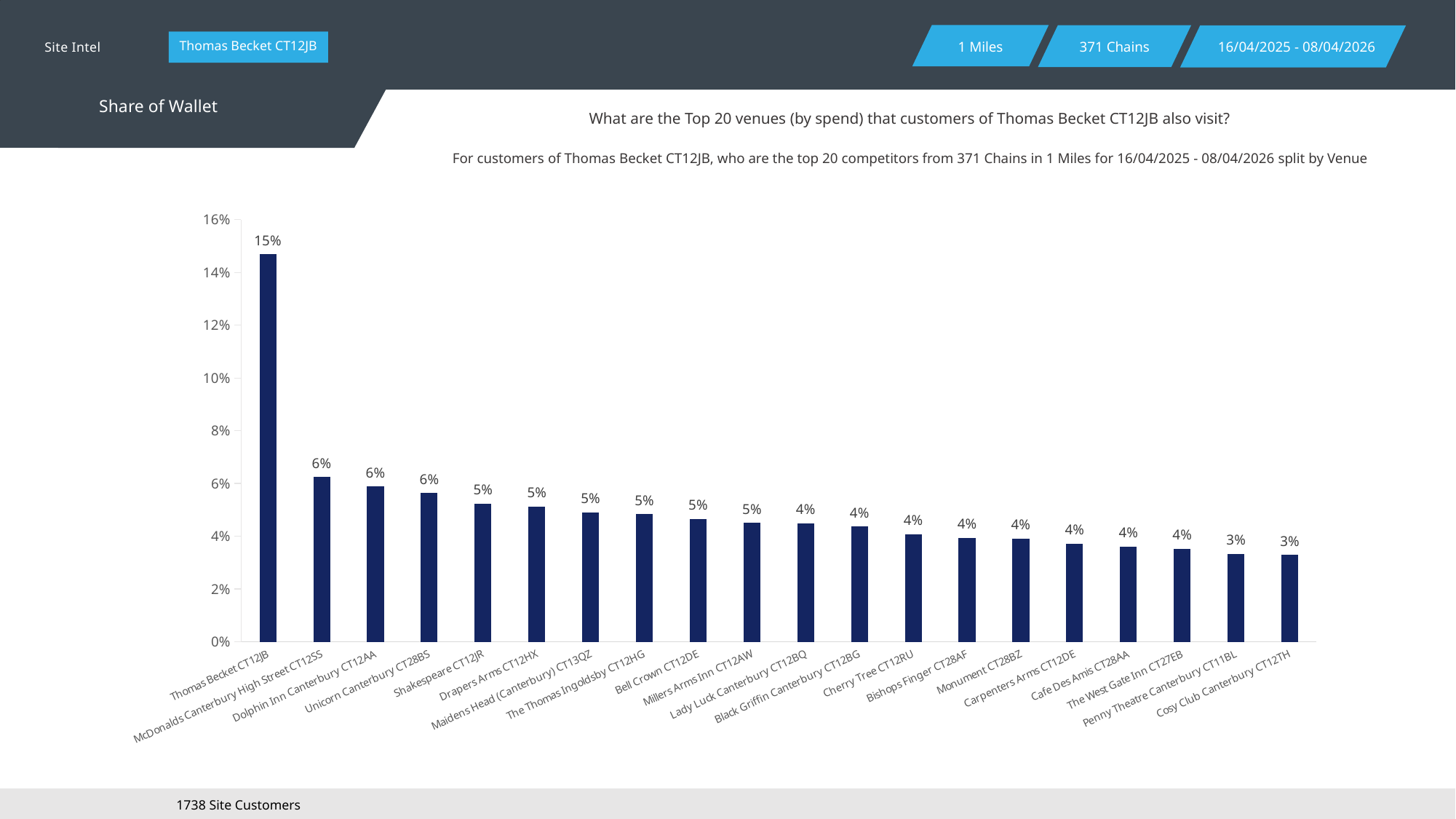
What is the value for McDonalds Canterbury High Street CT12SS? 6% Which venue has the highest value? Thomas Becket CT12JB What is the difference between the values for Thomas Becket CT12JB and McDonalds Canterbury High Street CT12SS? 9% What kind of chart is shown on the slide? bar chart What is the value for Thomas Becket CT12JB? 15% Which is larger, the value for Thomas Becket CT12JB or the value for Shakespeare CT12JR? Thomas Becket CT12JB What is the value for Cosy Club Canterbury CT12TH? 3% What is the value for Shakespeare CT12JR? 5% How many venues are shown on the chart? 20 Is the value for Thomas Becket CT12JB greater or less than 14%? greater Do the values rise or fall from left to right along the x axis? fall What is the value for Lady Luck Canterbury CT12BQ? 4%